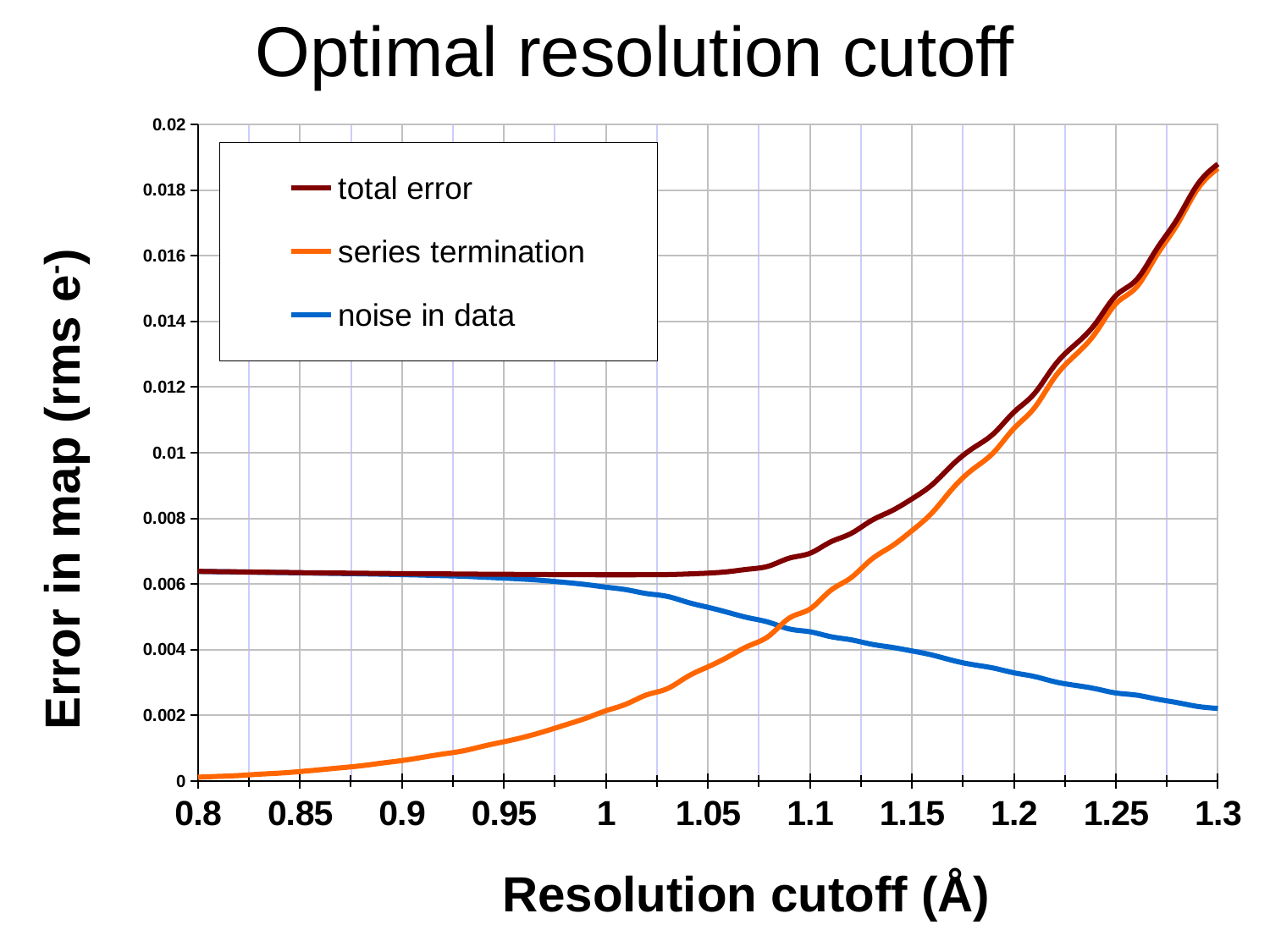
How many series does the legend list? 3 Does the 'series termination' line rise or fall as the resolution cutoff increases from 0.8 to 1.3? rise At a resolution cutoff of 1.3, which is higher: 'series termination' or 'noise in data'? series termination What is the title of the chart? Optimal resolution cutoff Is the value of 'series termination' at a resolution cutoff of 1.3 greater or less than 0.016? greater Which series has the lowest value at a resolution cutoff of 1.3? noise in data Is the value of 'total error' at a resolution cutoff of 0.8 greater or less than 0.008? less What kind of chart is shown on the slide? line chart Does the 'noise in data' line rise or fall as the resolution cutoff increases from 0.8 to 1.3? fall Is the value of 'series termination' at a resolution cutoff of 0.8 greater or less than 0.002? less At a resolution cutoff of 0.8, which is higher: 'noise in data' or 'series termination'? noise in data